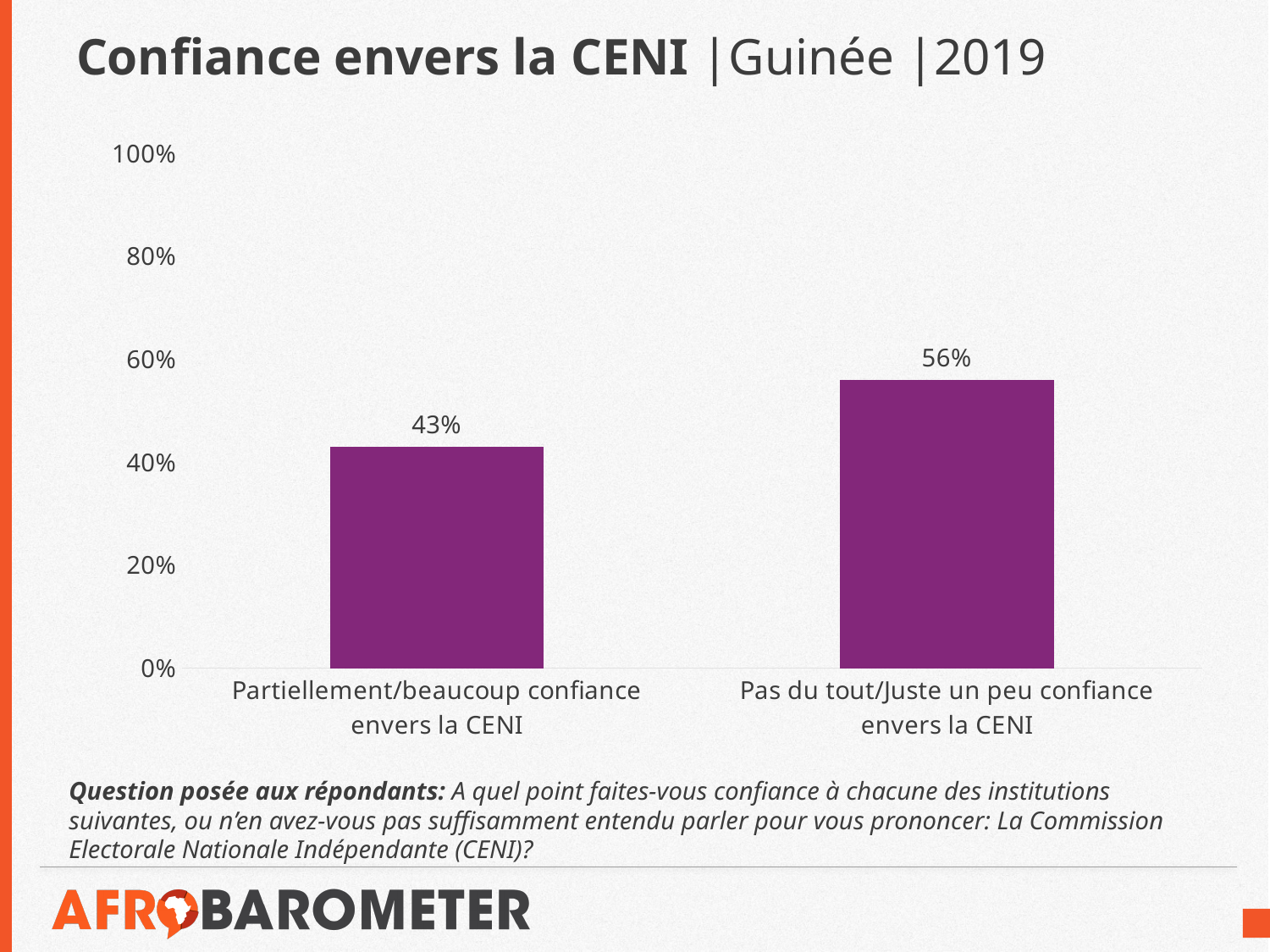
Is the value for "Pas du tout/Juste un peu confiance envers la CENI" greater or less than 40%? greater Is the value for "Partiellement/beaucoup confiance envers la CENI" greater or less than 60%? less What colour are the bars in the chart? Purple How many categories are shown in the chart? 2 Which category has the highest value? Pas du tout/Juste un peu confiance envers la CENI What is the title of the chart? Confiance envers la CENI | Guinée | 2019 What is the value for "Partiellement/beaucoup confiance envers la CENI"? 43% What kind of chart is shown on the slide? Bar chart Which is larger: the value for "Partiellement/beaucoup confiance envers la CENI" or the value for "Pas du tout/Juste un peu confiance envers la CENI"? Pas du tout/Juste un peu confiance envers la CENI What is the value for "Pas du tout/Juste un peu confiance envers la CENI"? 56% Which category has the lowest value? Partiellement/beaucoup confiance envers la CENI What is the difference between the value for "Pas du tout/Juste un peu confiance envers la CENI" and the value for "Partiellement/beaucoup confiance envers la CENI"? 13%